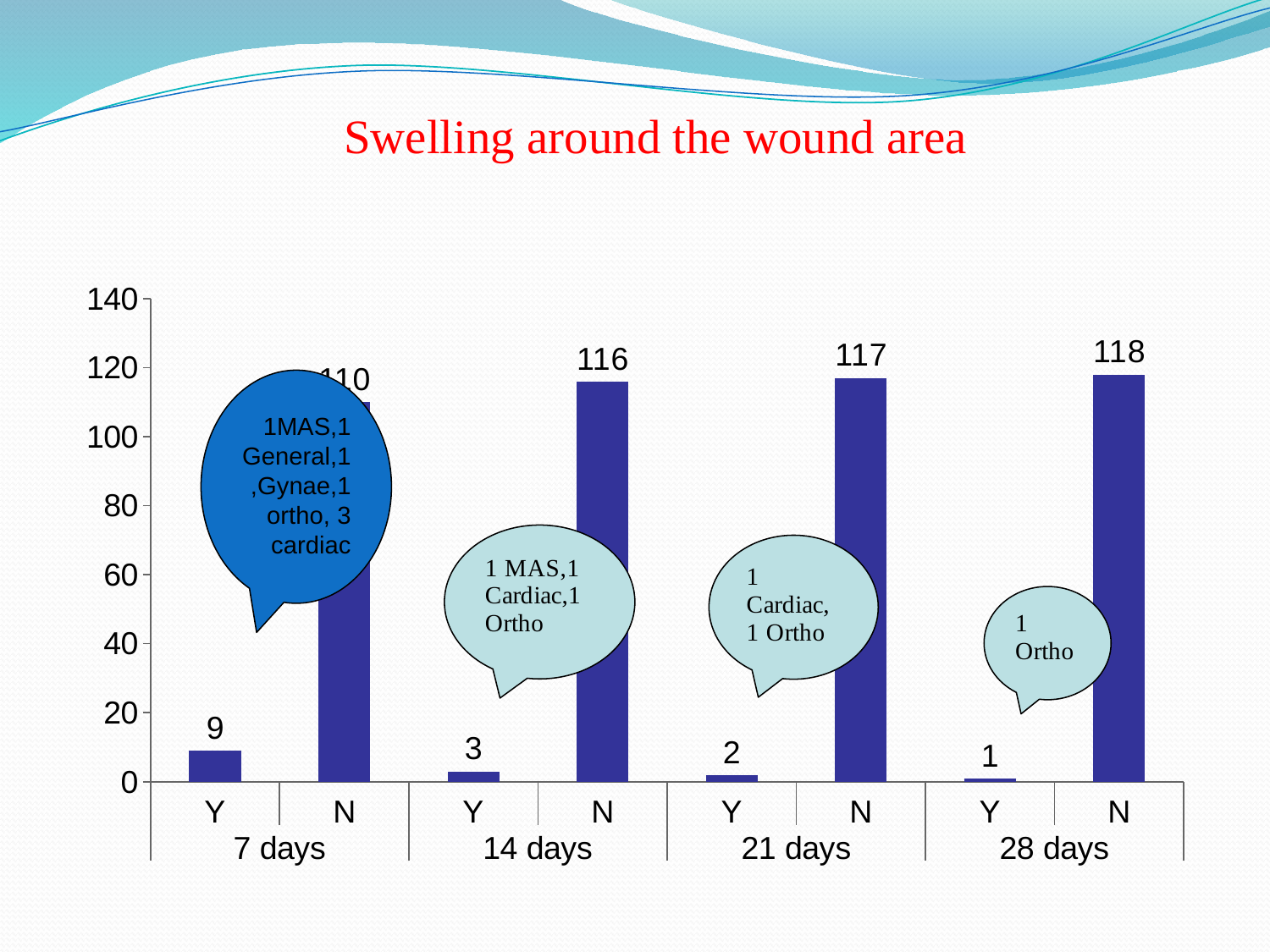
Which bar has the lowest value in the chart? Y at 28 days What is the title of the chart? Swelling around the wound area What is the difference between the N value at 28 days and the N value at 14 days? 2 Is the value for N at 7 days greater or less than 100? greater How many time-point groups are shown on the x axis? 4 Which is larger, the Y value at 7 days or the Y value at 14 days? Y at 7 days What is the value for N at 28 days? 118 What is the value for Y at 7 days? 9 Which bar has the highest value in the chart? N at 28 days What is the value for Y at 21 days? 2 What is the value for N at 14 days? 116 What kind of chart is shown on the slide? bar chart